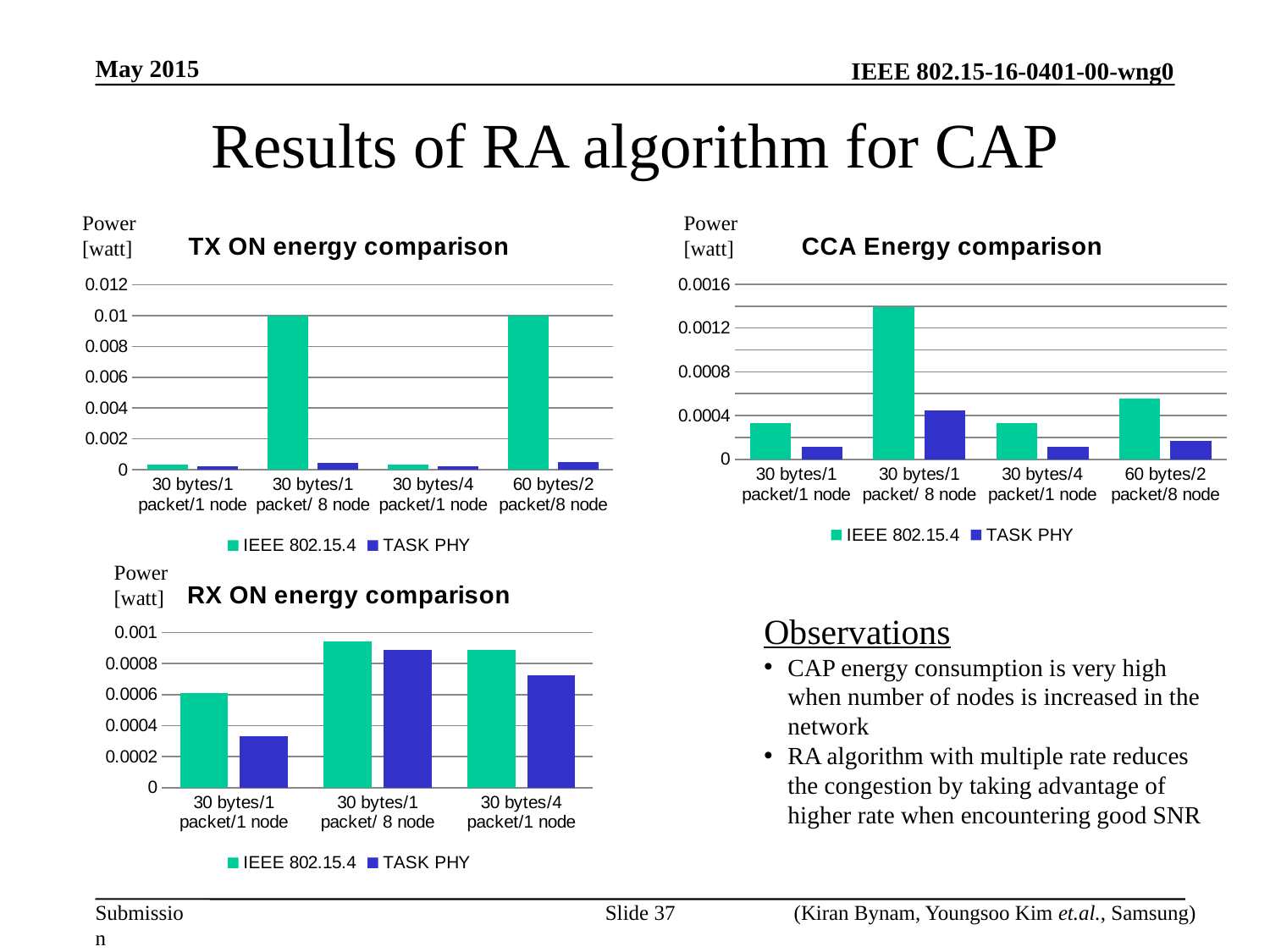
What unit is shown on the y axis label of the "CCA Energy comparison" chart? Power [watt] How many categories are shown on the x axis of the "CCA Energy comparison" chart? 4 How many categories are shown on the x axis of the "RX ON energy comparison" chart? 3 In the "RX ON energy comparison" chart, which is larger for "30 bytes/1 packet/1 node": the IEEE 802.15.4 value or the TASK PHY value? IEEE 802.15.4 In the "TX ON energy comparison" chart, is the IEEE 802.15.4 value for "30 bytes/1 packet/ 8 node" greater or less than 0.008? greater In the "CCA Energy comparison" chart, is the IEEE 802.15.4 value for "30 bytes/1 packet/ 8 node" greater or less than 0.0012? greater How many series does the legend of the "CCA Energy comparison" chart list? 2 What kind of chart is the "TX ON energy comparison" chart? bar chart In the "RX ON energy comparison" chart, which category has the lowest TASK PHY value? 30 bytes/1 packet/1 node In the "CCA Energy comparison" chart, which category has the highest IEEE 802.15.4 value? 30 bytes/1 packet/ 8 node In the "RX ON energy comparison" chart, is the IEEE 802.15.4 value for "30 bytes/1 packet/ 8 node" greater or less than 0.0008? greater